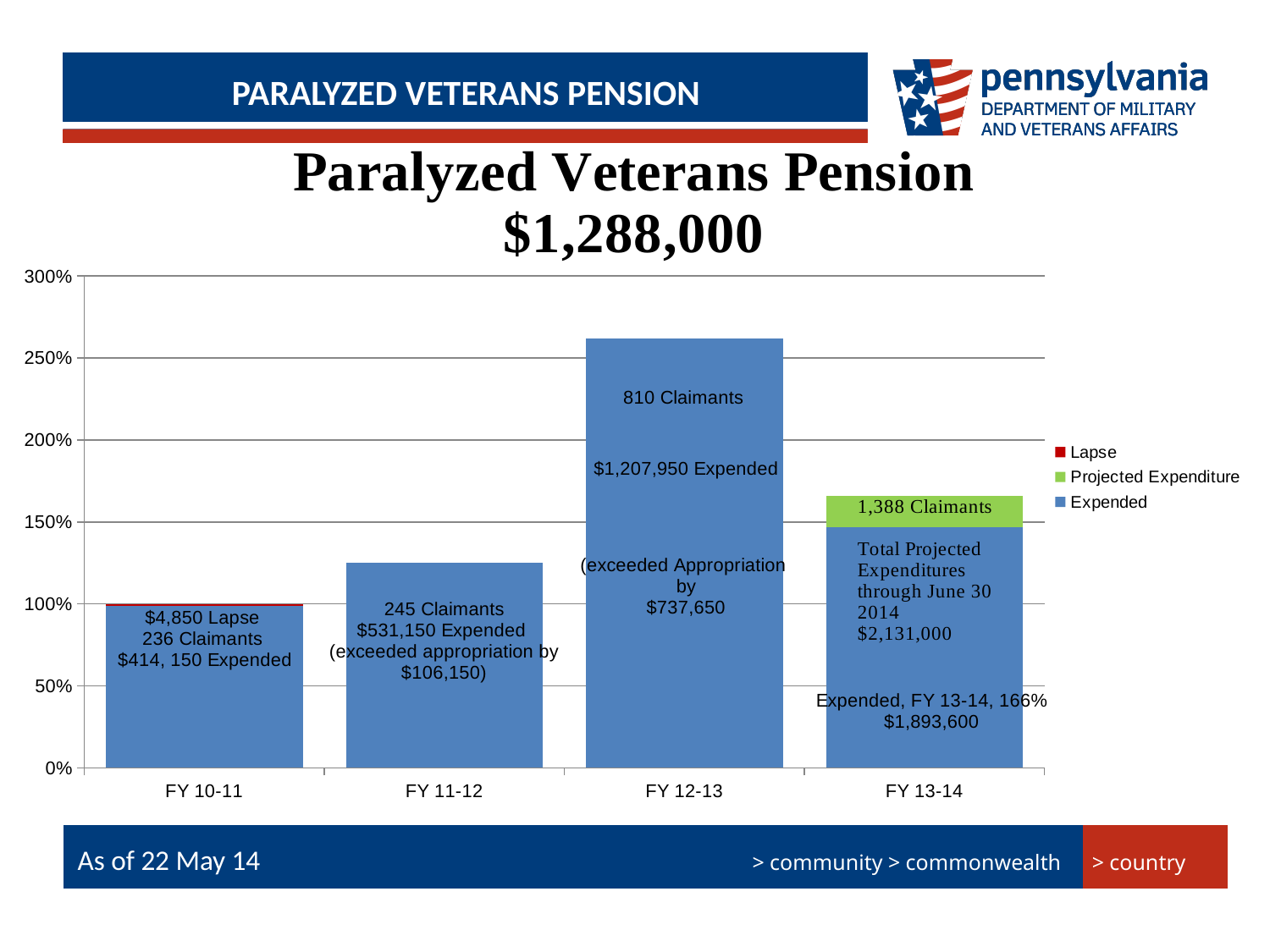
What type of chart is shown on the slide? bar chart Is the bar for FY 11-12 greater or less than 150%? less How many series does the chart's legend list? 3 Which fiscal year has the tallest bar in the chart? FY 12-13 How many fiscal years are shown on the x axis of the chart? 4 By how much did FY 11-12 exceed its appropriation according to the chart label? $106,150 Which bar is taller, FY 11-12 or FY 13-14? FY 13-14 What lapse amount is shown for FY 10-11? $4,850 Which fiscal year has the shortest bar in the chart? FY 10-11 Is the bar for FY 12-13 greater or less than 250%? greater How many claimants are shown for FY 12-13? 810 Claimants What are the three entries in the chart's legend? Lapse, Projected Expenditure, Expended